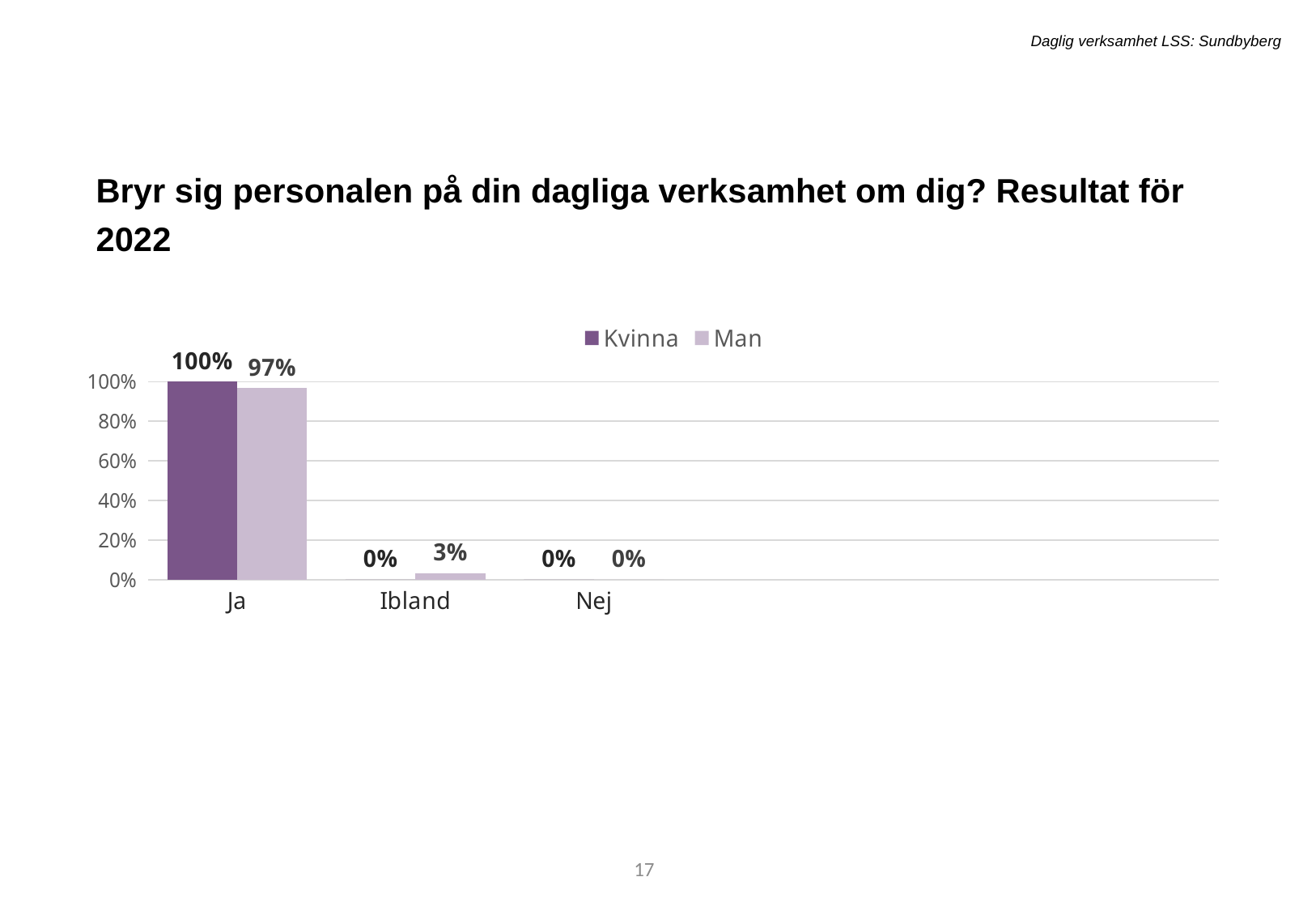
What is the difference between the Kvinna and Man values in the Ja category? 3% Which category has the highest value for the Man series? Ja What is the value for Man in the Ja category? 97% What is the value for Kvinna in the Nej category? 0% How many categories are shown on the x axis? 3 What is the value for Kvinna in the Ja category? 100% In the Ja category, which series has the larger value, Kvinna or Man? Kvinna How many series does the legend list? 2 What kind of chart is shown on the slide? bar chart Is the value for Man in the Ja category greater or less than 80%? greater What are the two series named in the legend? Kvinna and Man What is the value for Man in the Ibland category? 3%